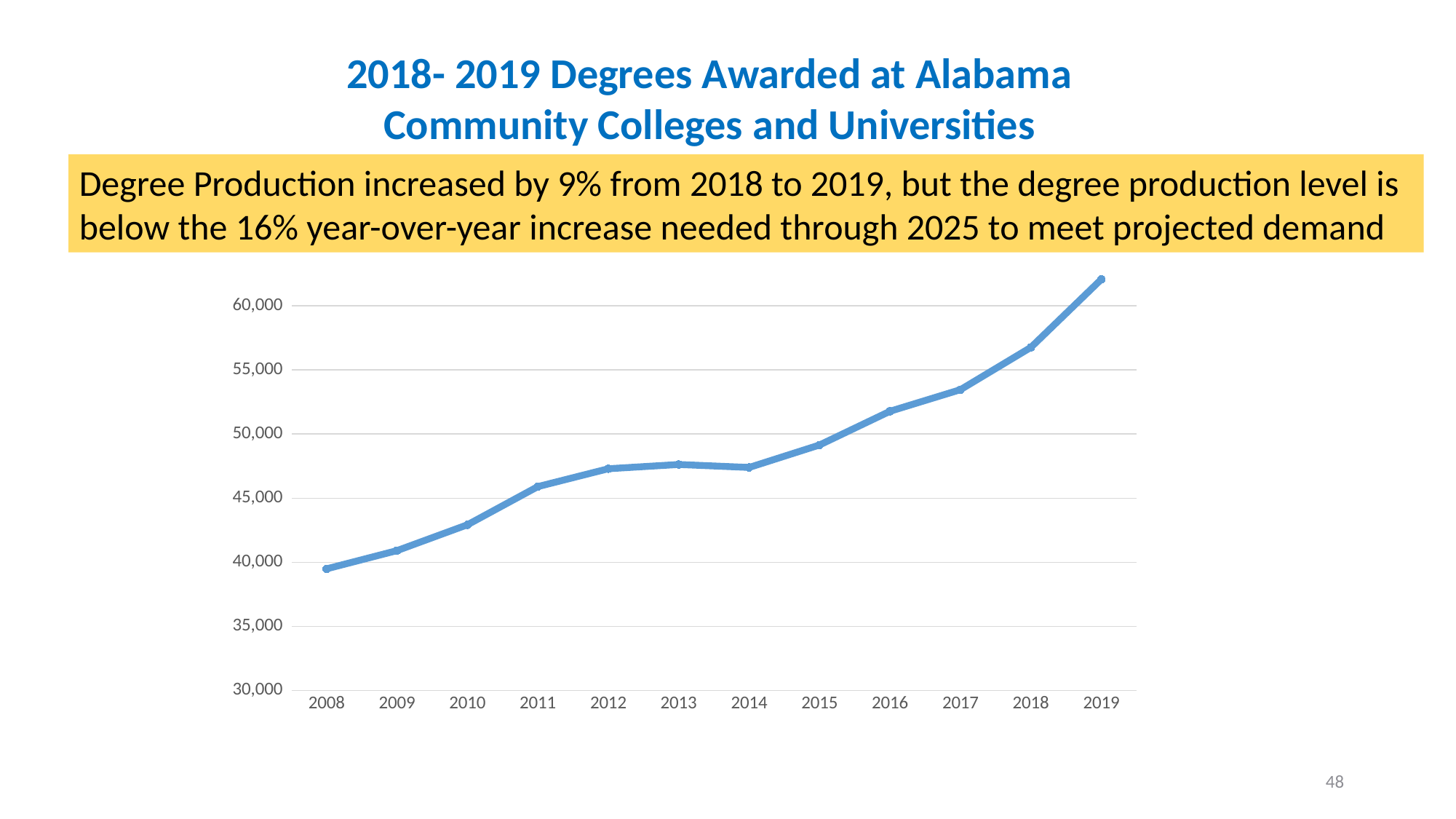
What is the title of the slide containing the chart? 2018- 2019 Degrees Awarded at Alabama Community Colleges and Universities Is the value for 2015 greater or less than 50,000? less Is the value for 2008 greater or less than 40,000? less Is the value for 2019 greater or less than 60,000? greater Which year has the larger value, 2012 or 2018? 2018 How many years are plotted along the x axis of the chart? 12 Overall, do the values rise or fall from 2008 to 2019? rise Which year has the highest number of degrees awarded in the chart? 2019 Which year has the lowest number of degrees awarded in the chart? 2008 What kind of chart is shown on the slide? line chart